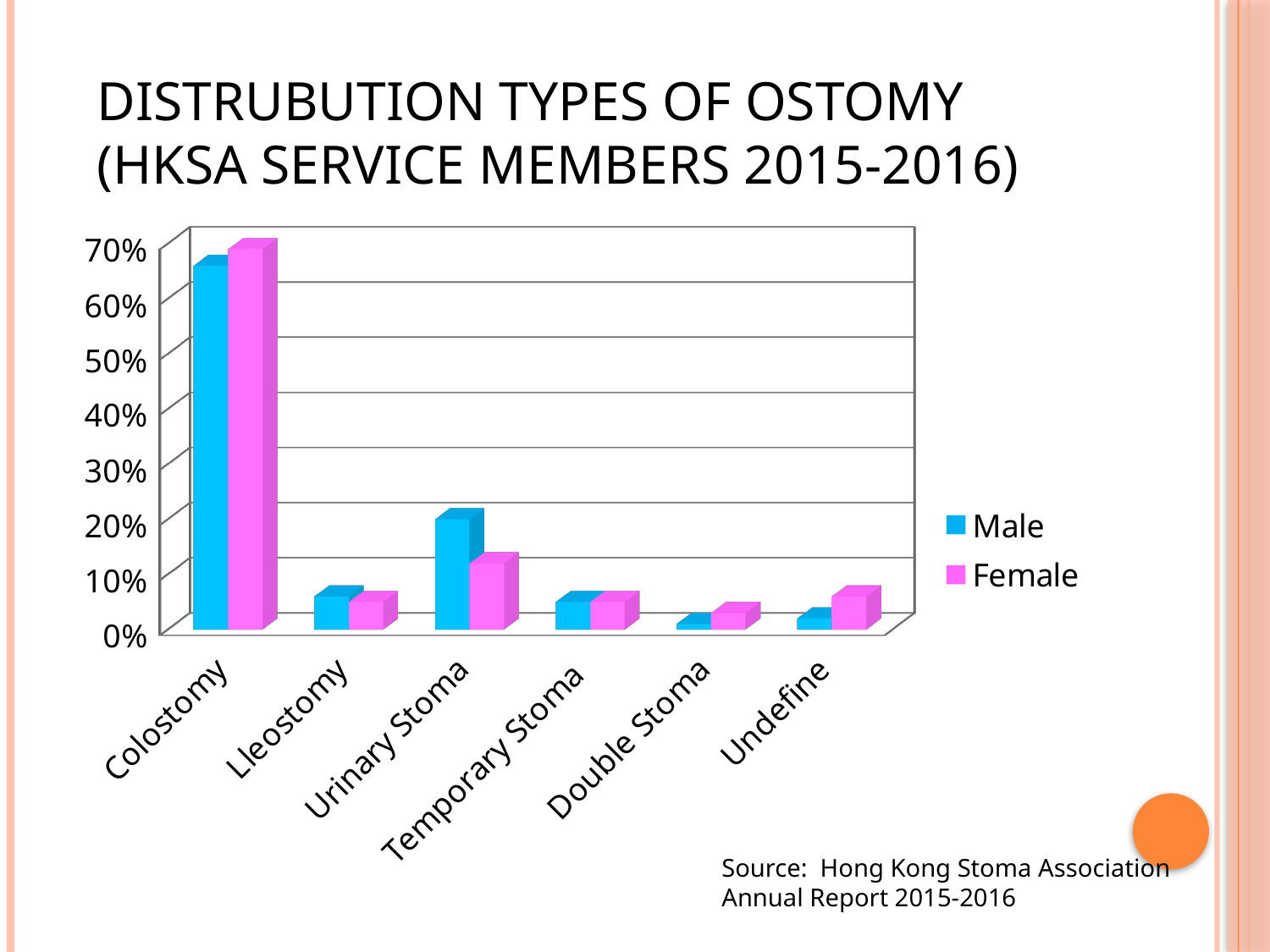
How many ostomy type categories are shown on the x axis? 6 Is the Male value for Colostomy greater or less than 60%? greater Is the Male value for Urinary Stoma greater or less than 30%? less For Urinary Stoma, which is larger, the Male value or the Female value? Male How many series does the legend list? 2 For Undefine, which is larger, the Male value or the Female value? Female Is the Male value for Lleostomy greater or less than 10%? less Which ostomy type has the highest Male value? Colostomy For Colostomy, which is larger, the Male value or the Female value? Female What kind of chart is shown on the slide? Bar chart Which ostomy type has the highest Female value? Colostomy Which colour represents the Female series in the legend? Pink